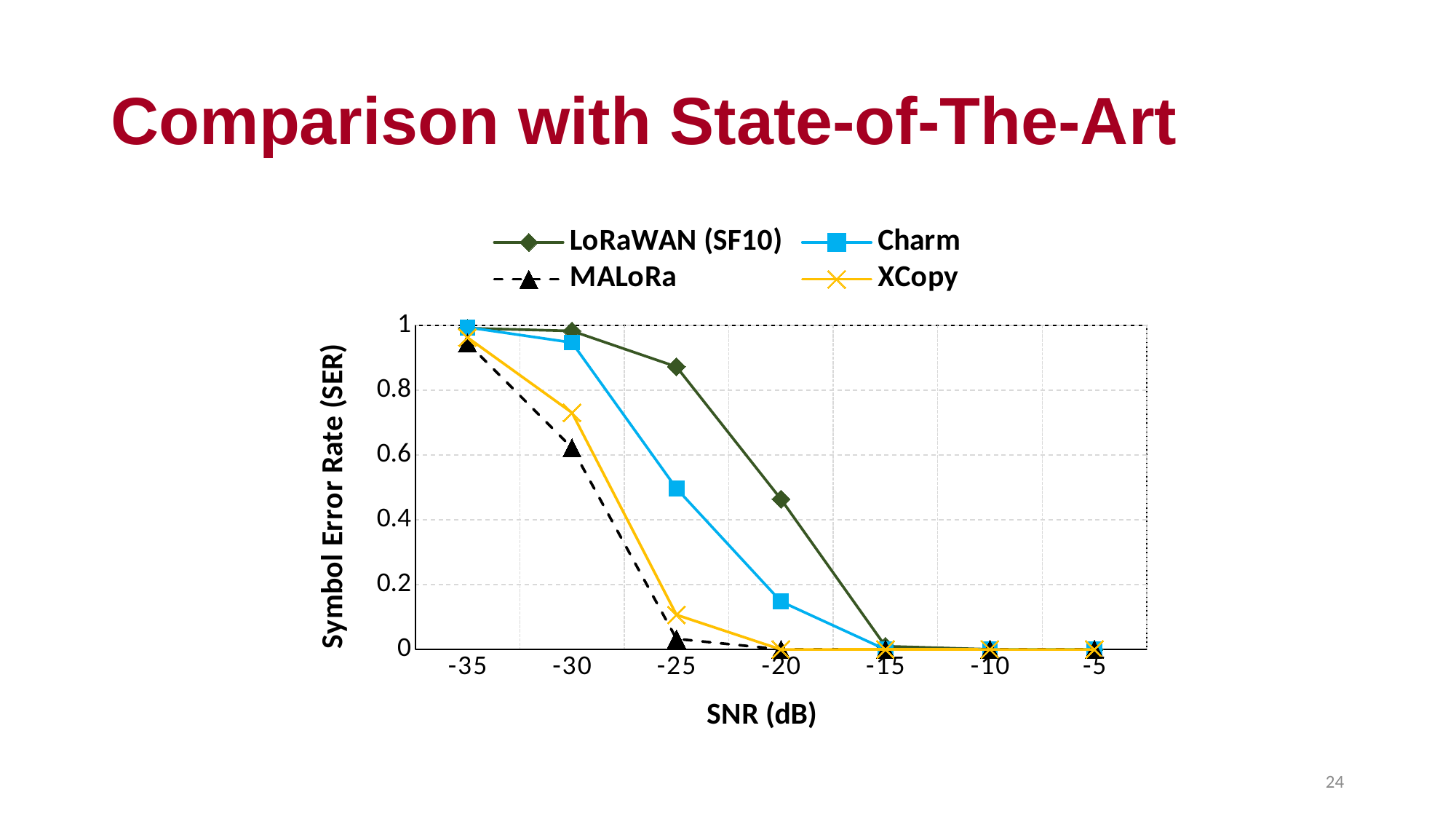
Which series has the lowest Symbol Error Rate at an SNR of -30 dB? MALoRa At an SNR of -25 dB, which has the higher Symbol Error Rate, LoRaWAN (SF10) or Charm? LoRaWAN (SF10) Do the Symbol Error Rate values rise or fall as SNR increases along the x axis? fall What is the label of the y axis? Symbol Error Rate (SER) Is the Symbol Error Rate for Charm at -20 dB greater or less than 0.2? less At an SNR of -30 dB, which has the higher Symbol Error Rate, XCopy or MALoRa? XCopy What kind of chart is shown on the slide? line chart How many SNR values are plotted along the x axis? 7 Is the Symbol Error Rate for XCopy at -25 dB greater or less than 0.2? less Which series has the highest Symbol Error Rate at an SNR of -25 dB? LoRaWAN (SF10) How many series does the legend list? 4 Is the Symbol Error Rate for LoRaWAN (SF10) at -25 dB greater or less than 0.8? greater